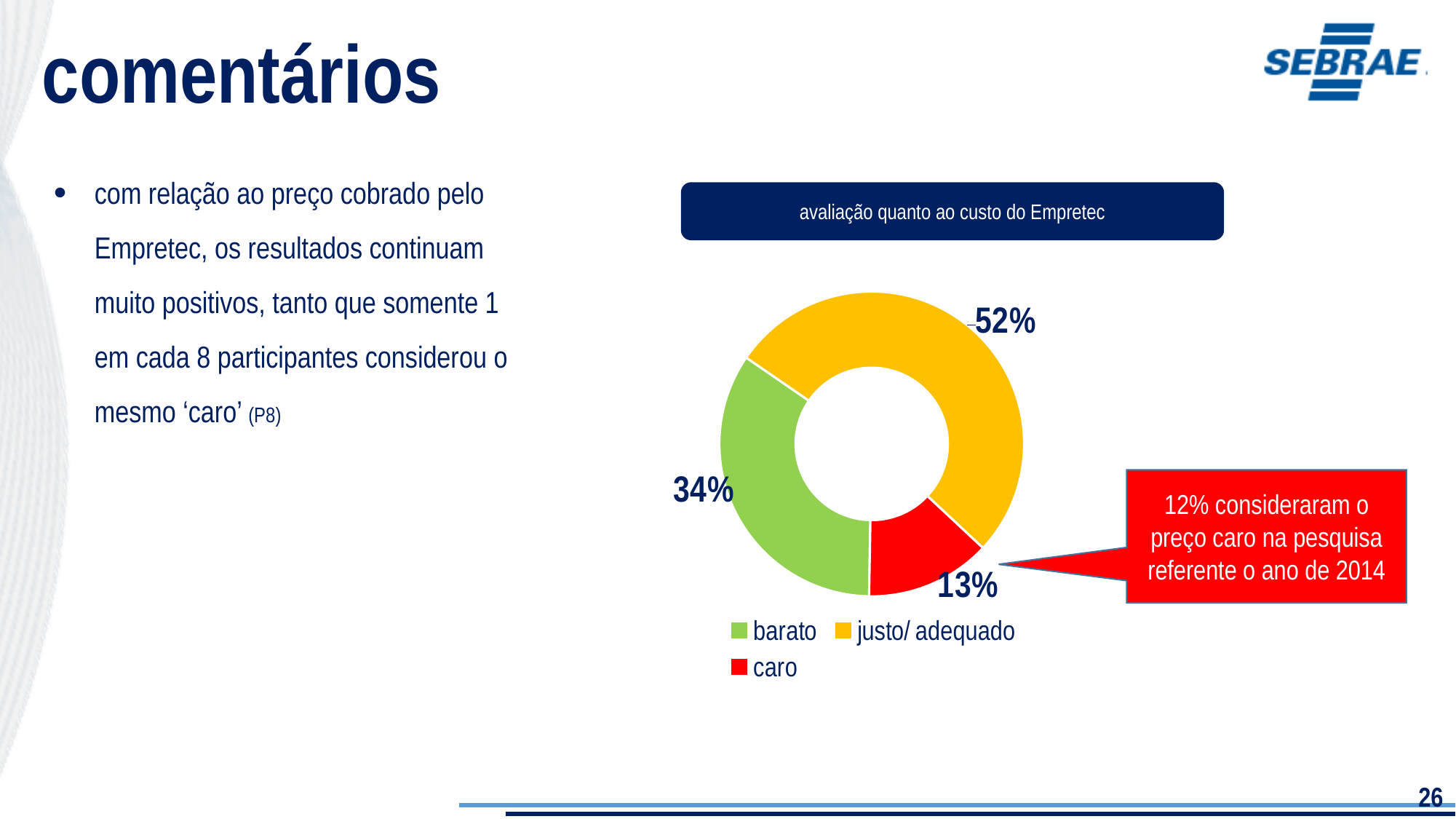
Which category has the smallest share in the chart? caro How many categories does the chart show? 3 What is the title of the chart? avaliação quanto ao custo do Empretec What share of respondents rated the cost of Empretec as 'barato'? 34% Which is larger, the share for 'barato' or the share for 'caro'? barato Which category has the largest share in the chart? justo/ adequado What kind of chart is shown on the slide? Doughnut (pie) chart What is the difference in percentage points between the 'justo/ adequado' and 'barato' shares? 18 What share of respondents rated the cost of Empretec as 'caro'? 13% What is the difference in percentage points between the 'barato' and 'caro' shares? 21 Which colour represents the 'caro' category in the chart? Red What share of respondents rated the cost of Empretec as 'justo/ adequado'? 52%